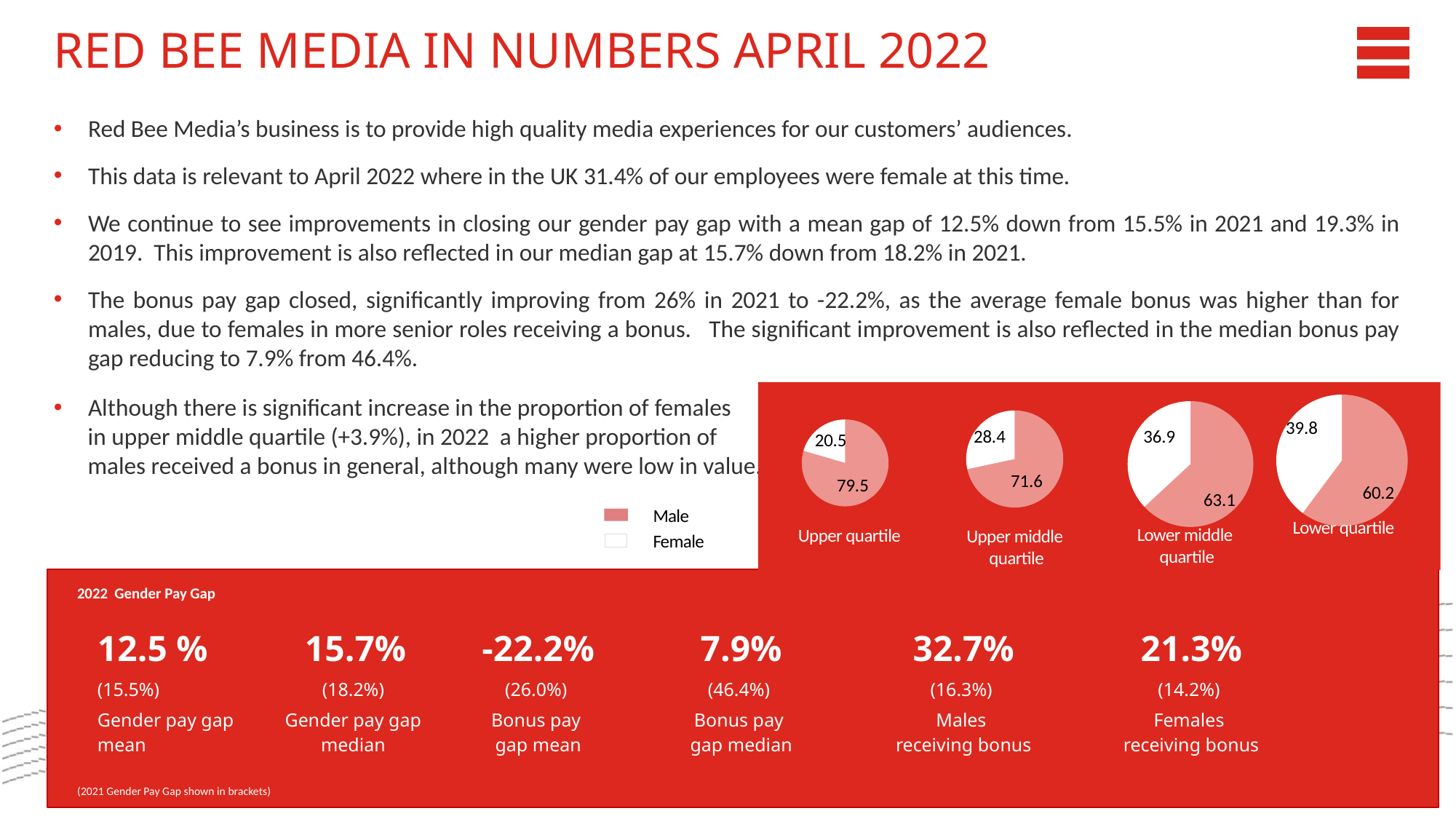
In the Lower quartile pie chart, which slice is larger, Male or Female? Male Across the four pie charts, which quartile has the highest Female value? Lower quartile In the Upper middle quartile pie chart, what is the value for Female? 28.4 In the Lower middle quartile pie chart, what is the difference between the Male and Female values? 26.2 Across the four pie charts, which quartile has the lowest Male value? Lower quartile In the Upper middle quartile pie chart, what is the difference between the Male and Female values? 43.2 How many entries does the legend for the pie charts list? 2 In the Upper quartile pie chart, what is the value for Female? 20.5 How many pie charts are shown on the slide? 4 In the Lower quartile pie chart, what is the value for Female? 39.8 In the Lower middle quartile pie chart, what is the value for Male? 63.1 In the Upper quartile pie chart, what is the value for Male? 79.5